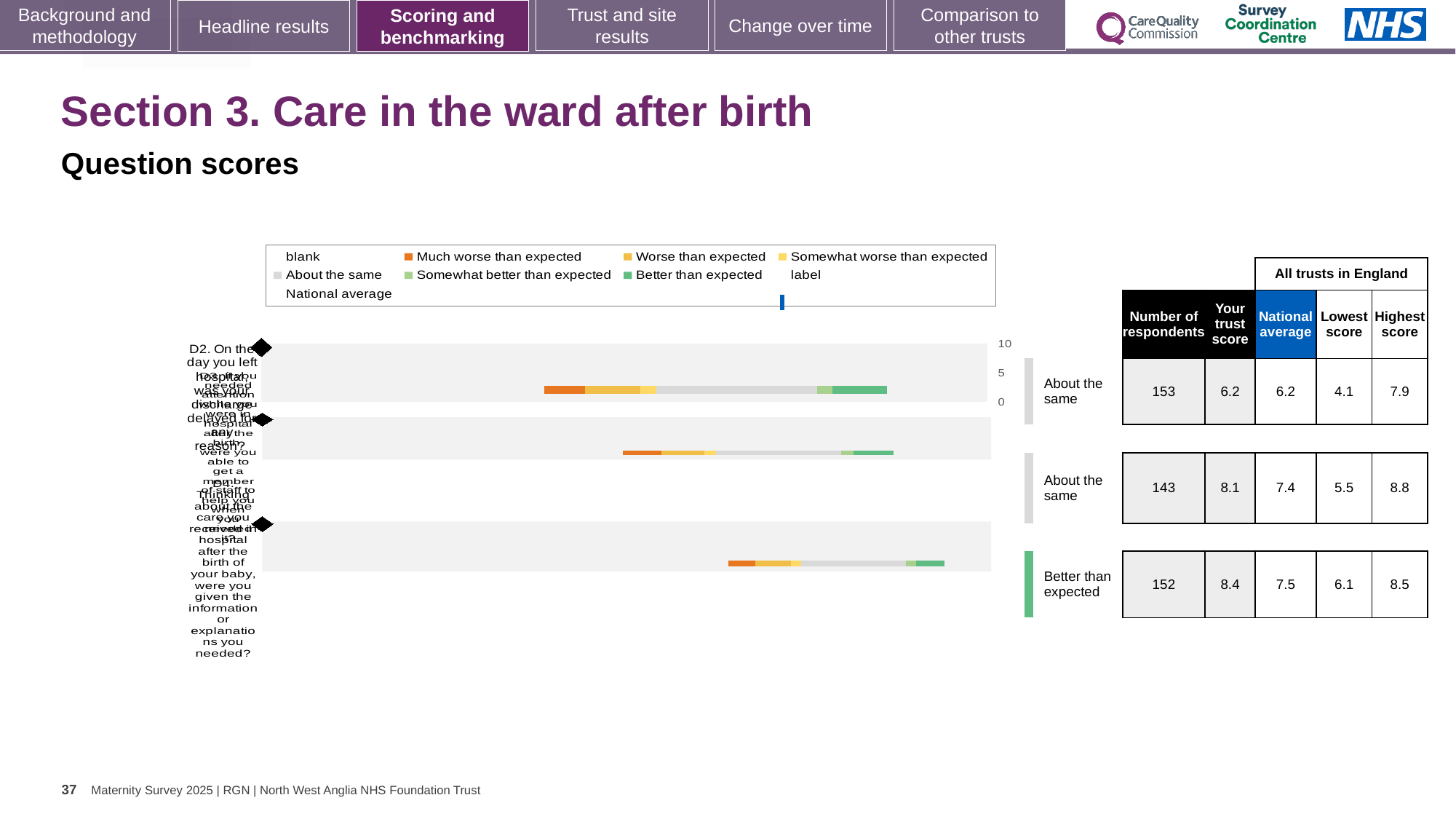
In the table next to the chart, is "Your trust score" for the middle row higher or lower than the national average? higher In the table next to the chart, what is the lowest score for the top row? 4.1 How many question rows (bars) are plotted in the chart? 3 In the table next to the chart, what is the difference between "Your trust score" and the national average for the bottom row? 0.9 In the chart legend, what colour represents "Much worse than expected"? orange What kind of chart is shown on the slide? bar chart In the chart legend, what colour represents "Better than expected"? green In the table next to the chart, what is the highest score for the middle row? 8.8 In the table next to the chart, what is "Your trust score" for the bottom row? 8.4 In the table next to the chart, what is the number of respondents for the top row? 153 In the table next to the chart, which row has the highest "Your trust score"? the bottom row (8.4) What benchmark label is shown beside the bottom row of the chart? Better than expected